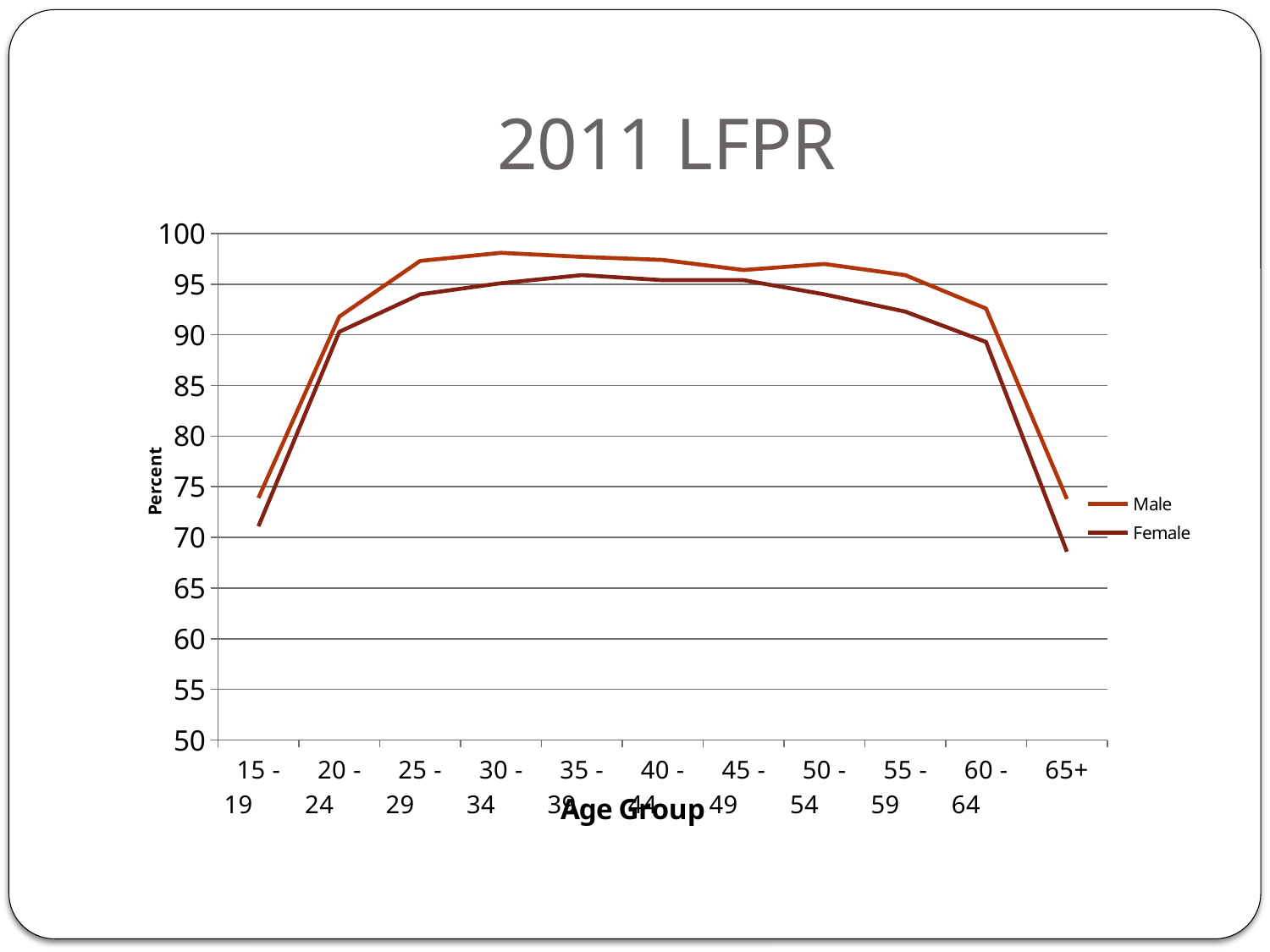
Is the Male value for the 30 - 34 age group greater or less than 95? greater What kind of chart is shown on the slide? line chart For the 25 - 29 age group, which series has the higher value, Male or Female? Male Is the Female value for the 65+ age group greater or less than 70? less Does the Male line rise or fall from the 50 - 54 age group to the 65+ age group? fall Is the Female value for the 15 - 19 age group greater or less than 75? less How many series does the legend list? 2 Which age group has the lowest Female value? 65+ What is the label of the y axis? Percent What is the title of the chart? 2011 LFPR How many age groups are plotted along the x axis? 11